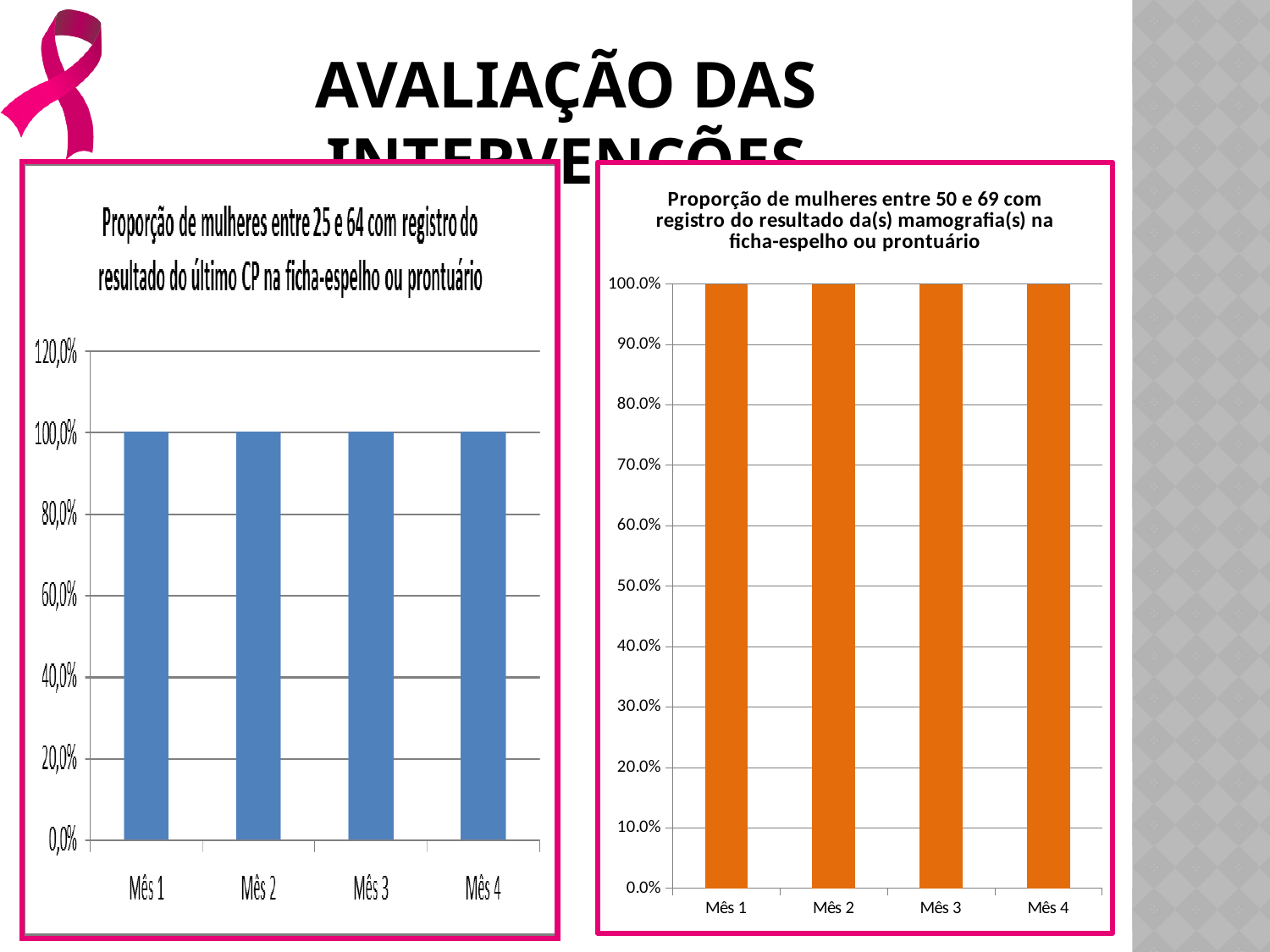
What kind of chart is the left chart (Proporção de mulheres entre 25 e 64)? Bar chart In the left chart (Proporção de mulheres entre 25 e 64), do the values rise, fall or stay the same from Mês 1 to Mês 4? Stay the same In the left chart (Proporção de mulheres entre 25 e 64), what is the value for Mês 4? 100,0% In the left chart (Proporção de mulheres entre 25 e 64), how many months are shown on the x axis? 4 In the right chart (Proporção de mulheres entre 50 e 69), what is the value for Mês 2? 100.0% In the left chart (Proporção de mulheres entre 25 e 64), is the value for Mês 2 greater or less than 80,0%? greater What colour are the bars in the right chart (Proporção de mulheres entre 50 e 69)? Orange In the left chart (Proporção de mulheres entre 25 e 64), what is the value for Mês 1? 100,0% In the right chart (Proporção de mulheres entre 50 e 69), do the values rise, fall or stay the same from Mês 1 to Mês 4? Stay the same What kind of chart is the right chart (Proporção de mulheres entre 50 e 69)? Bar chart In the right chart (Proporção de mulheres entre 50 e 69), what is the value for Mês 3? 100.0% In the right chart (Proporção de mulheres entre 50 e 69), how many bars are plotted? 4